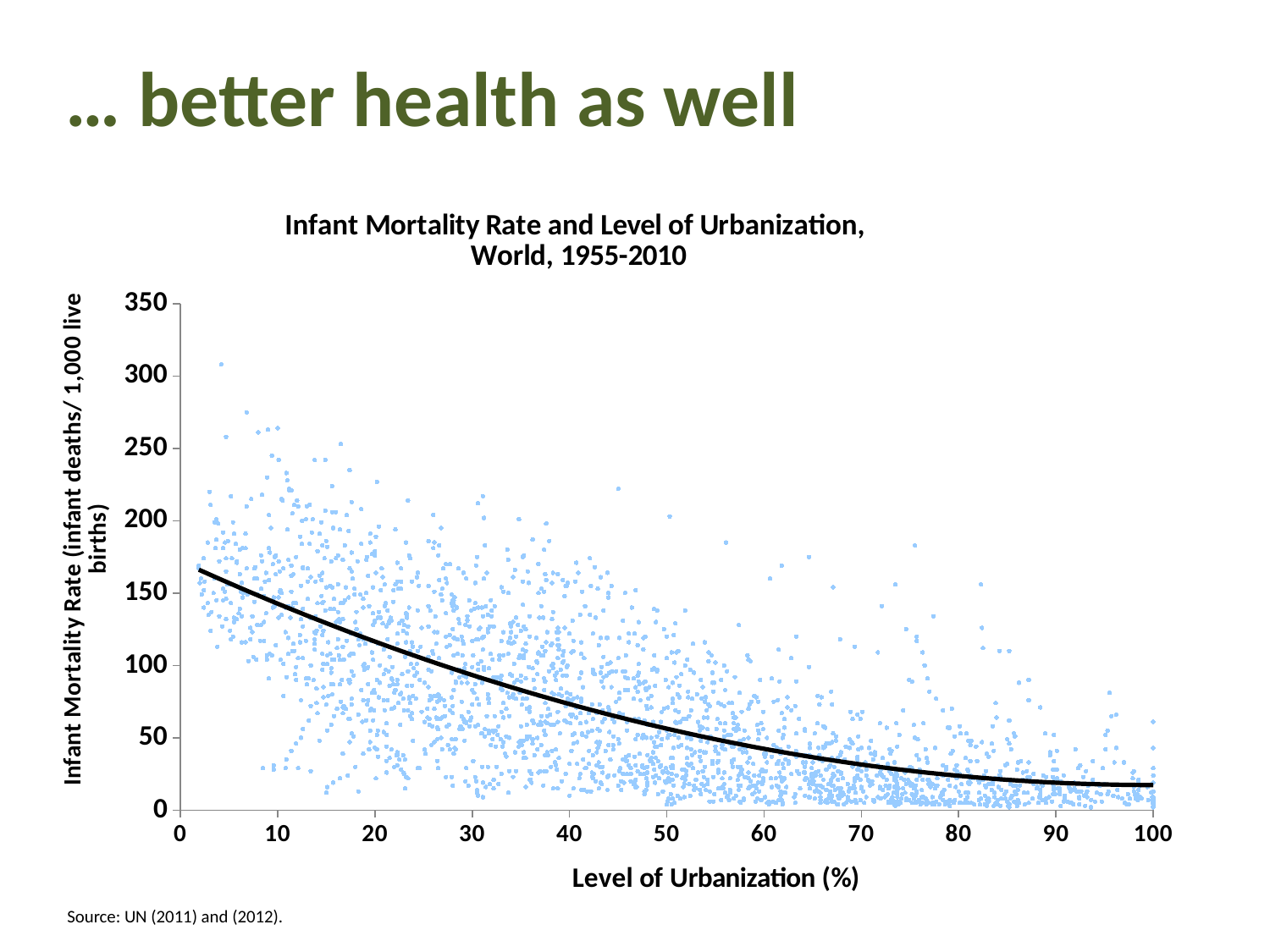
As the level of urbanization increases along the x axis, does the infant mortality rate trend line rise or fall? fall Is the trend line value at a level of urbanization of 20% greater or less than 100? greater Is the trend line value at the lowest plotted level of urbanization (about 2%) greater or less than 150? greater What is the highest value shown on the y axis? 350 What kind of chart is shown on the slide? scatter plot Is the trend line value at a level of urbanization of 80% greater or less than 50? less What is the title of the chart? Infant Mortality Rate and Level of Urbanization, World, 1955-2010